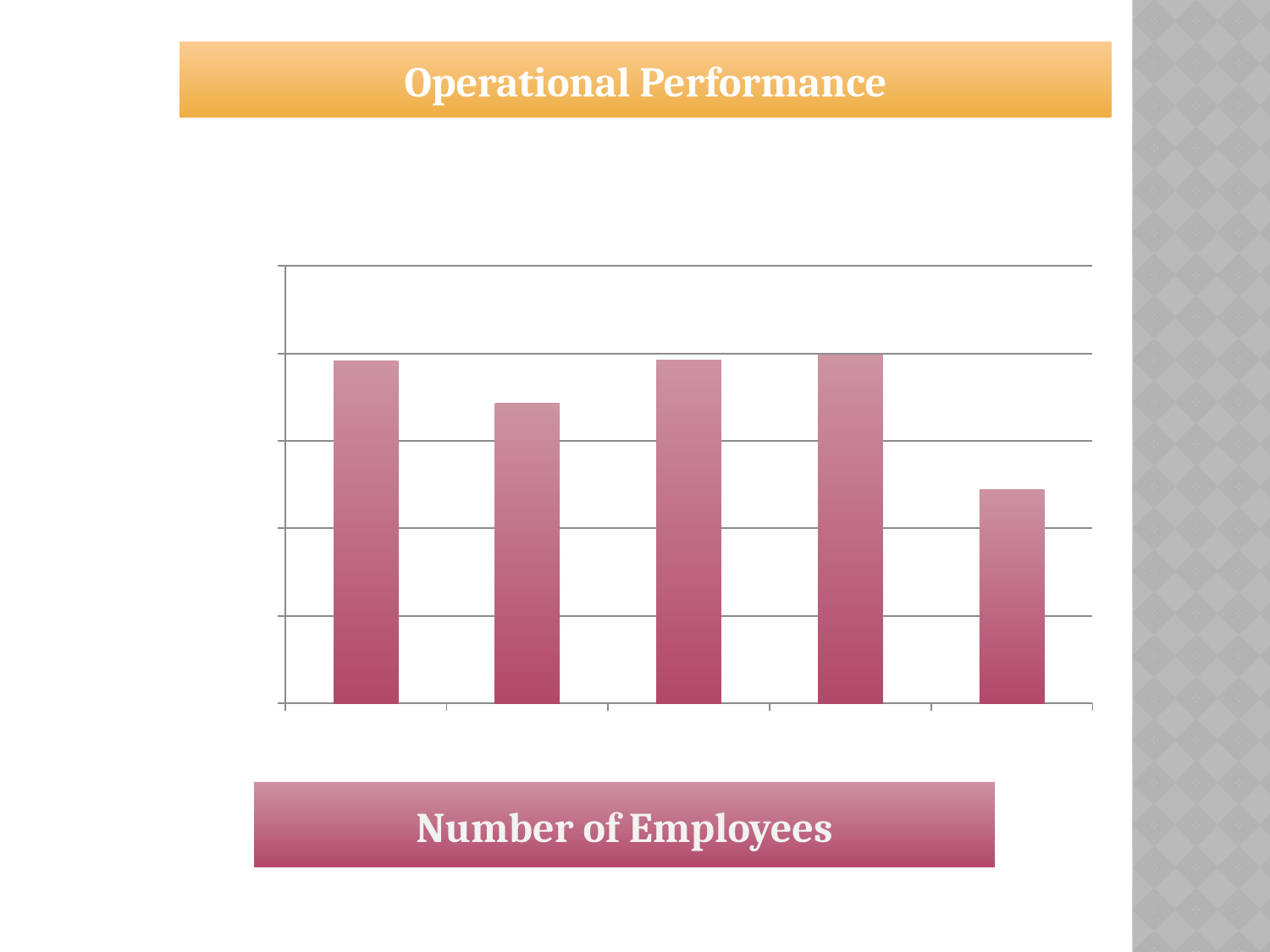
Is the fourth bar from the left taller or shorter than the fifth bar? Taller What does the label beneath the chart say the chart shows? Number of Employees What is the title at the top of the slide? Operational Performance Is the first bar from the left taller or shorter than the second bar? Taller Which bar, counted from the left, is the lowest in the chart? The fifth bar Is the second bar from the left taller or shorter than the fifth bar? Taller How many bars does the chart contain? 5 What kind of chart is shown on the slide? Bar chart